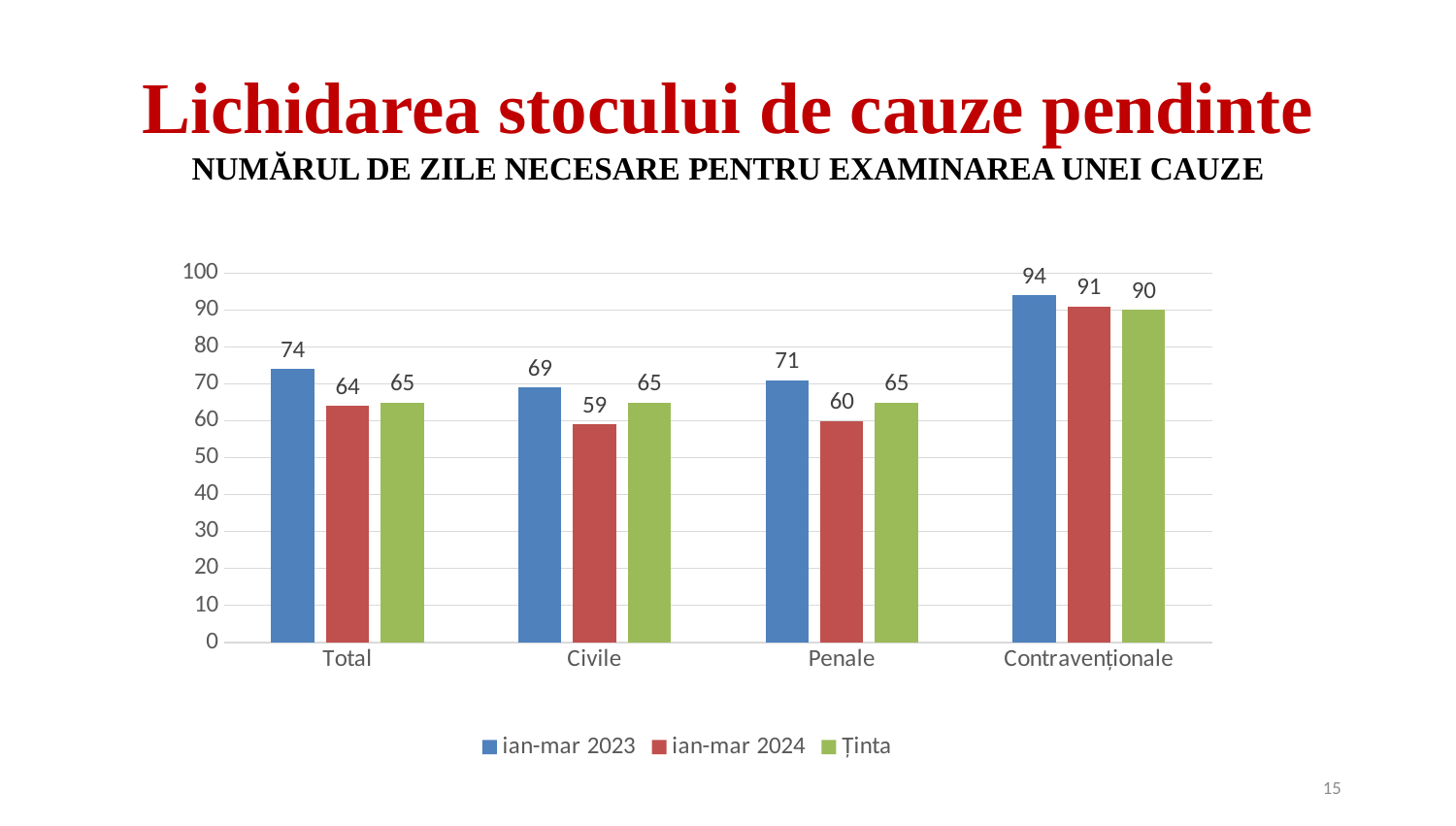
What is the value for Civile in the ian-mar 2024 series? 59 How many categories are shown on the x axis? 4 Which is larger for Civile: the ian-mar 2024 value or the Ținta value? Ținta What is the Ținta value for Penale? 65 What is the difference between the ian-mar 2023 and ian-mar 2024 values for Total? 10 What kind of chart is shown on the slide? Bar chart Which category has the lowest value in the ian-mar 2023 series? Civile How many series does the legend list? 3 What colour are the bars for the Ținta series? Green What is the value for Contravenționale in the ian-mar 2023 series? 94 Which category has the highest value in the ian-mar 2024 series? Contravenționale What is the difference between the ian-mar 2023 and ian-mar 2024 values for Penale? 11